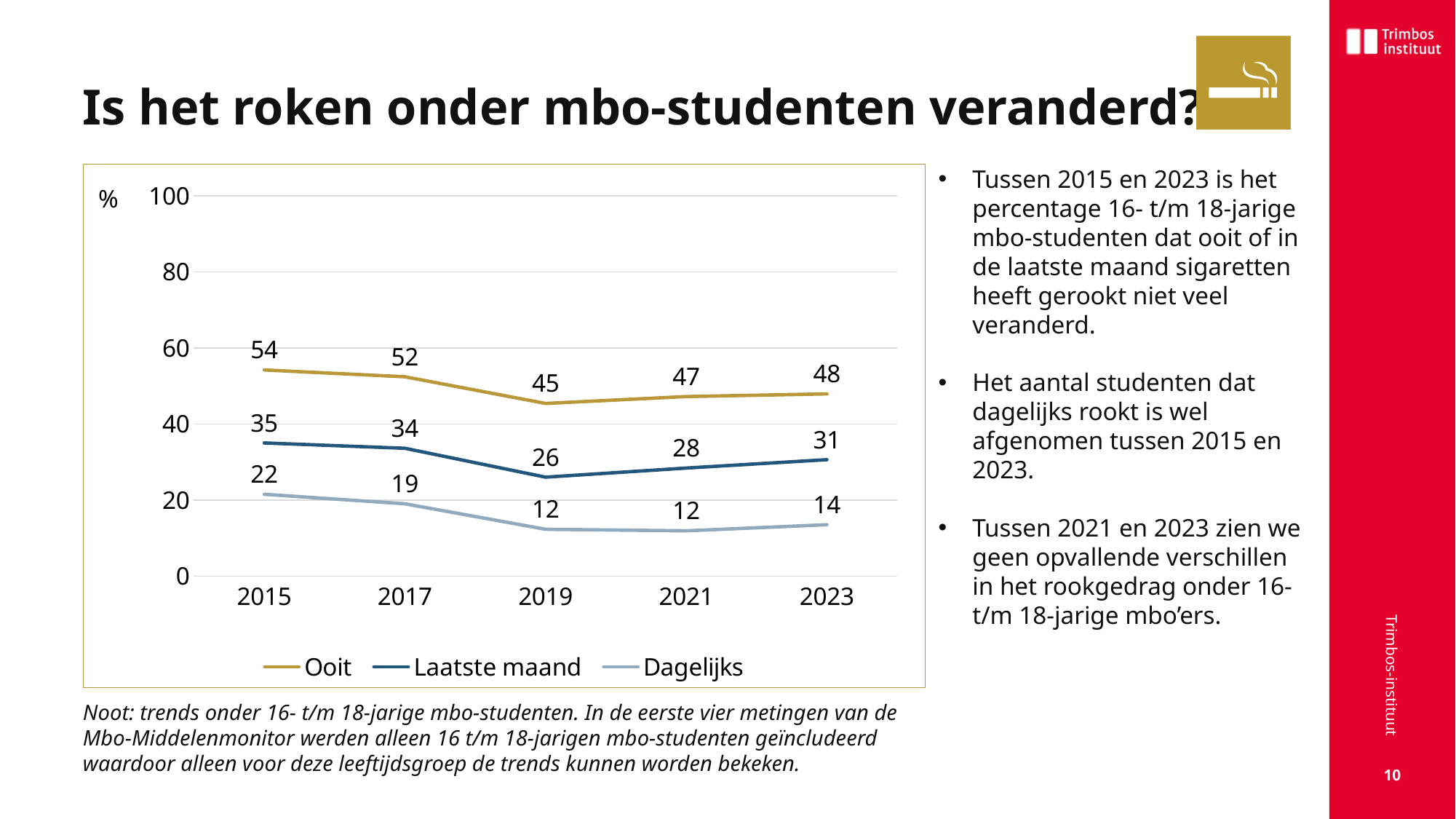
How many years are shown on the x axis? 5 Does the Dagelijks series rise or fall between 2015 and 2019? fall In which year is the Ooit series lowest? 2019 What is the difference between the Dagelijks values for 2015 and 2023? 8 What is the value for Laatste maand in 2019? 26 How many series does the legend list? 3 Which is larger: the Ooit value in 2021 or the Ooit value in 2023? 2023 What are the three legend entries of the chart? Ooit, Laatste maand, Dagelijks In which year is the Laatste maand series highest? 2015 What is the value for Ooit in 2015? 54 What kind of chart is shown on the slide? line chart What is the value for Dagelijks in 2023? 14